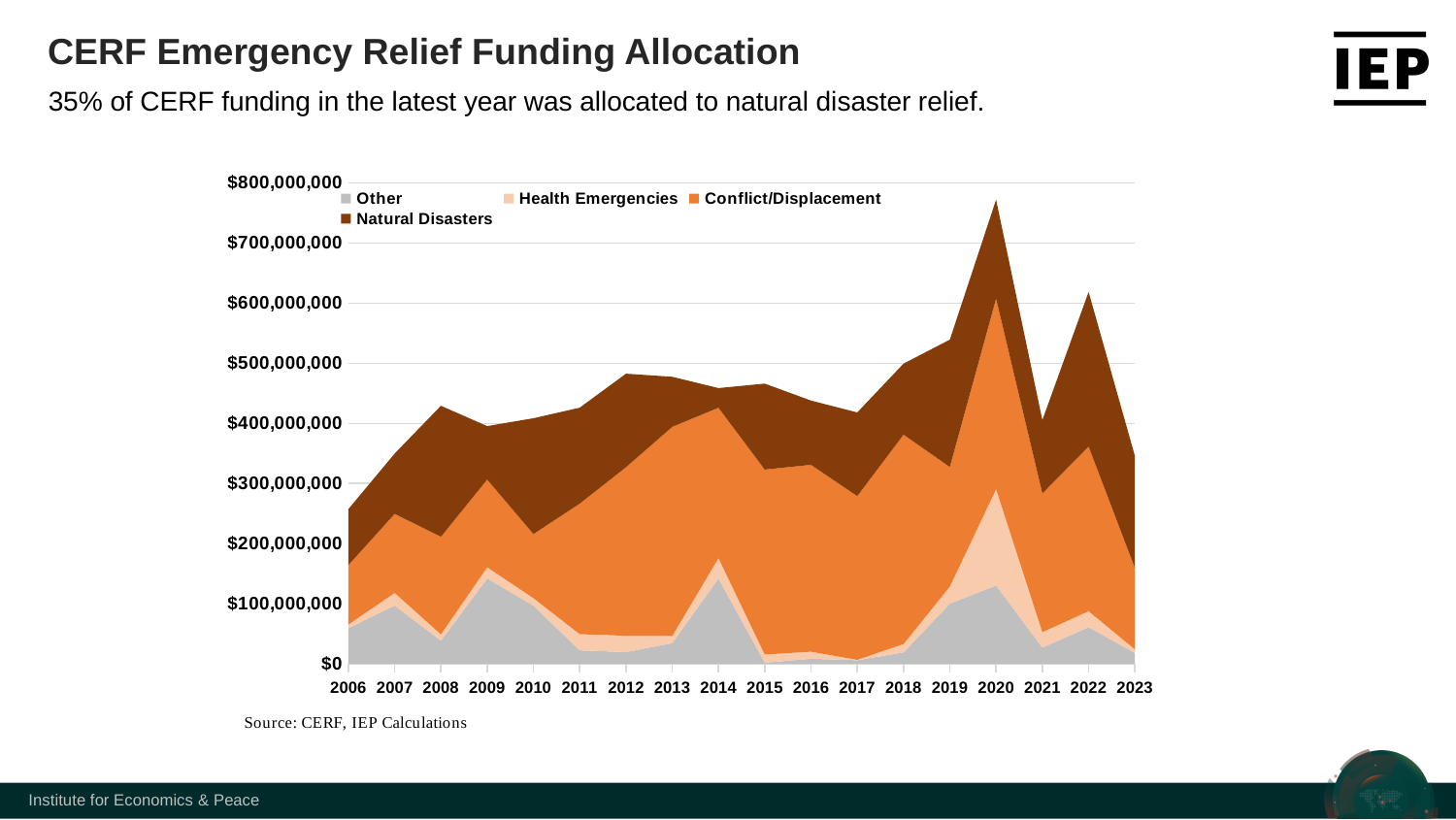
How many years are plotted along the x axis? 18 Which year has the highest total CERF funding? 2020 Which series is shown in the darkest brown colour at the top of the stack? Natural Disasters Is the total funding in 2006 greater or less than $300,000,000? less Which year has the larger total funding, 2020 or 2022? 2020 Does total funding rise or fall from 2020 to 2021? Fall What kind of chart is shown on the slide? Stacked area chart Which year has the lowest total CERF funding? 2006 Is the total funding in 2023 greater or less than $400,000,000? less What is the source cited below the chart? CERF, IEP Calculations How many series does the legend list? 4 Is the total funding in 2020 greater or less than $700,000,000? greater